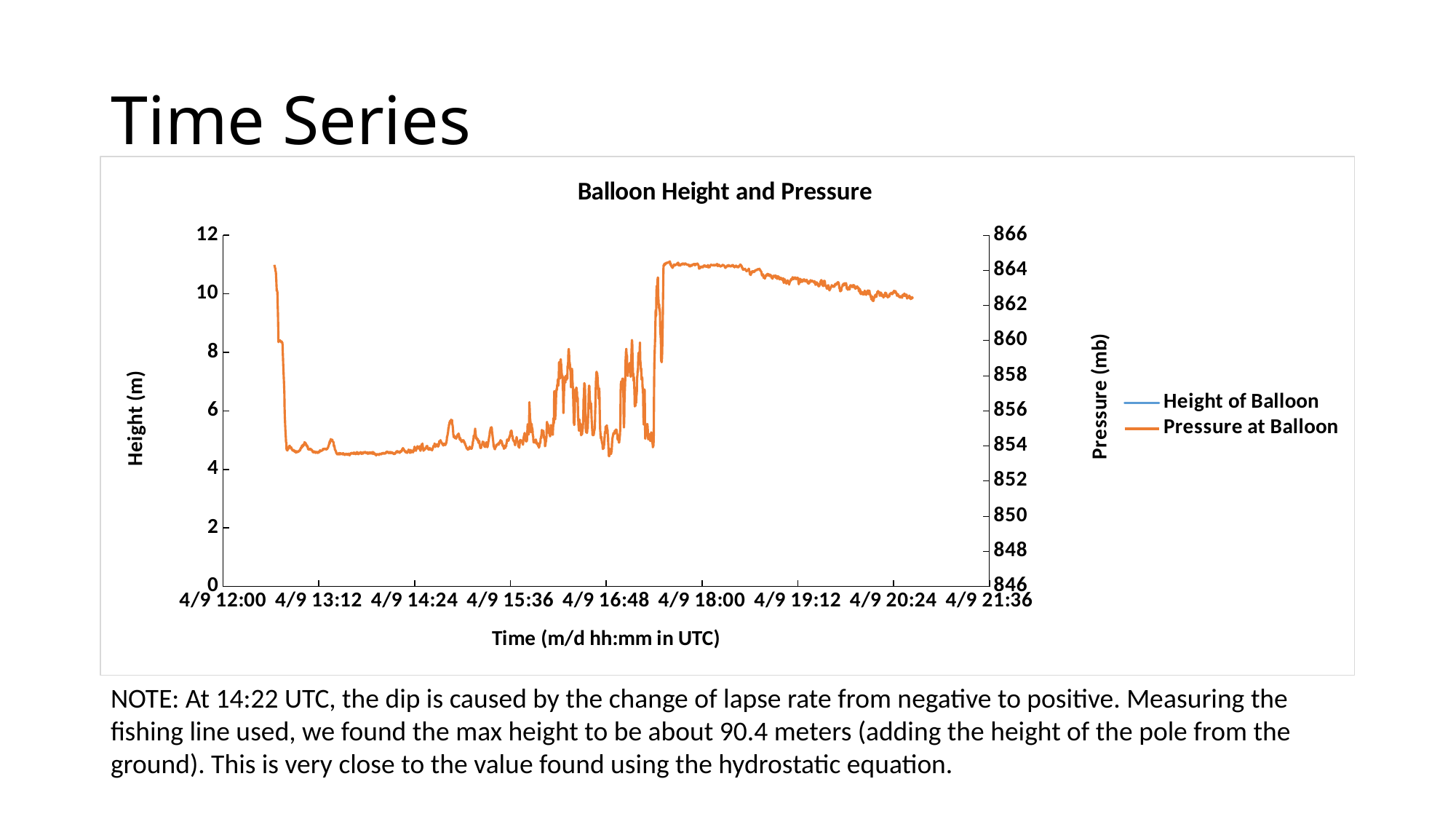
Is the pressure at the balloon at 4/9 19:12 greater or less than 862 mb? greater What is the highest tick value shown on the left Height (m) axis? 12 Which is larger, the pressure at the balloon at 4/9 14:24 or at 4/9 19:12? 4/9 19:12 What is the lowest tick value shown on the right Pressure (mb) axis? 846 Is the pressure at the balloon at 4/9 14:24 greater or less than 856 mb? less Between 4/9 18:00 and 4/9 20:24, does the pressure at the balloon rise or fall? fall How many series does the legend list? 2 What kind of chart is shown on the slide? line chart Is the pressure at the balloon at 4/9 18:00 greater or less than 860 mb? greater What is the title of the chart? Balloon Height and Pressure What is the label of the right-hand vertical axis? Pressure (mb)